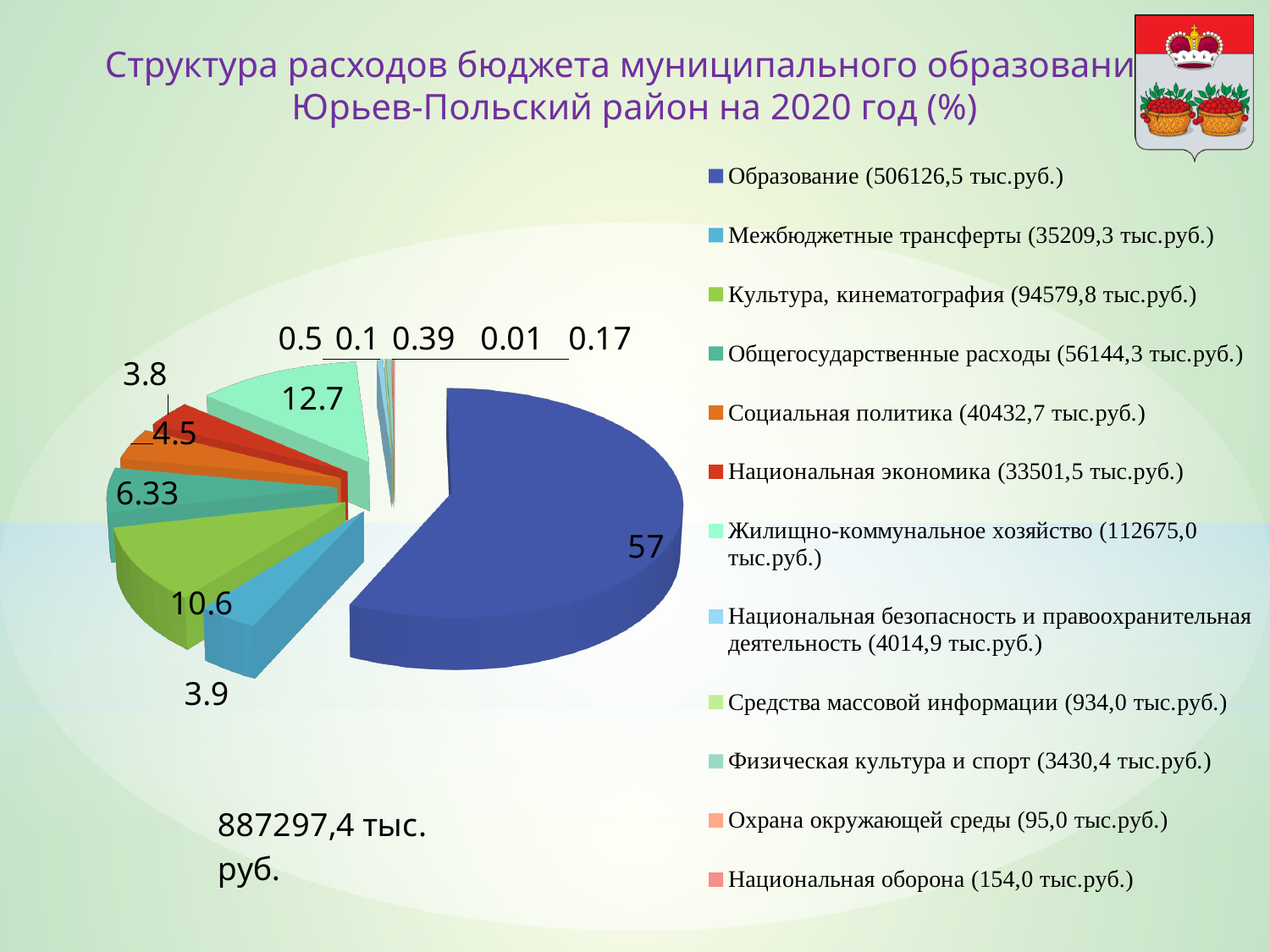
How many categories does the legend list? 12 What percentage share is shown for Образование? 57 What percentage share is shown for Культура, кинематография? 10.6 Which category has the smallest share of the pie? Охрана окружающей среды What percentage share is shown for Жилищно-коммунальное хозяйство? 12.7 What percentage share is shown for Общегосударственные расходы? 6.33 What kind of chart is shown on the slide? Pie chart What is the difference in percentage points between the shares of Образование and Жилищно-коммунальное хозяйство? 44.3 Which has a larger share: Культура, кинематография or Общегосударственные расходы? Культура, кинематография What total amount is printed below the pie chart? 887297,4 тыс. руб. According to the legend, what amount in тыс.руб. is given for Социальная политика? 40432,7 тыс.руб. Which category has the largest share of the pie? Образование